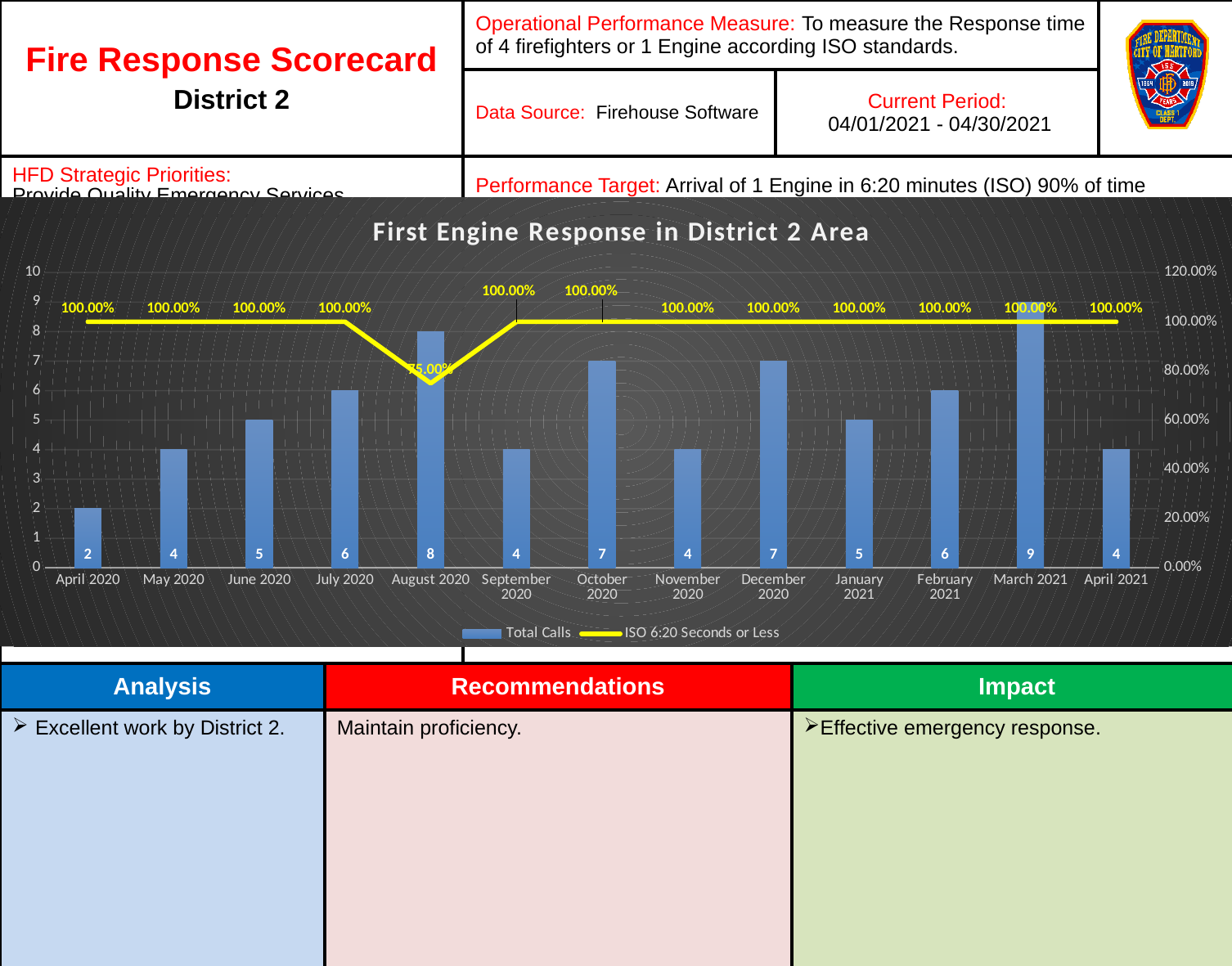
How many months are shown on the x axis of the chart? 13 What is the Total Calls value for August 2020? 8 What is the Total Calls value for April 2020? 2 What is the ISO 6:20 Seconds or Less value for April 2021? 100.00% What is the difference in Total Calls between March 2021 and April 2021? 5 What is the title of the chart? First Engine Response in District 2 Area Which month has more Total Calls, October 2020 or November 2020? October 2020 Which month has the lowest ISO 6:20 Seconds or Less percentage? August 2020 How many series does the chart legend list? 2 Which month has the lowest Total Calls? April 2020 What is the ISO 6:20 Seconds or Less value for August 2020? 75.00% Which month has the highest Total Calls? March 2021